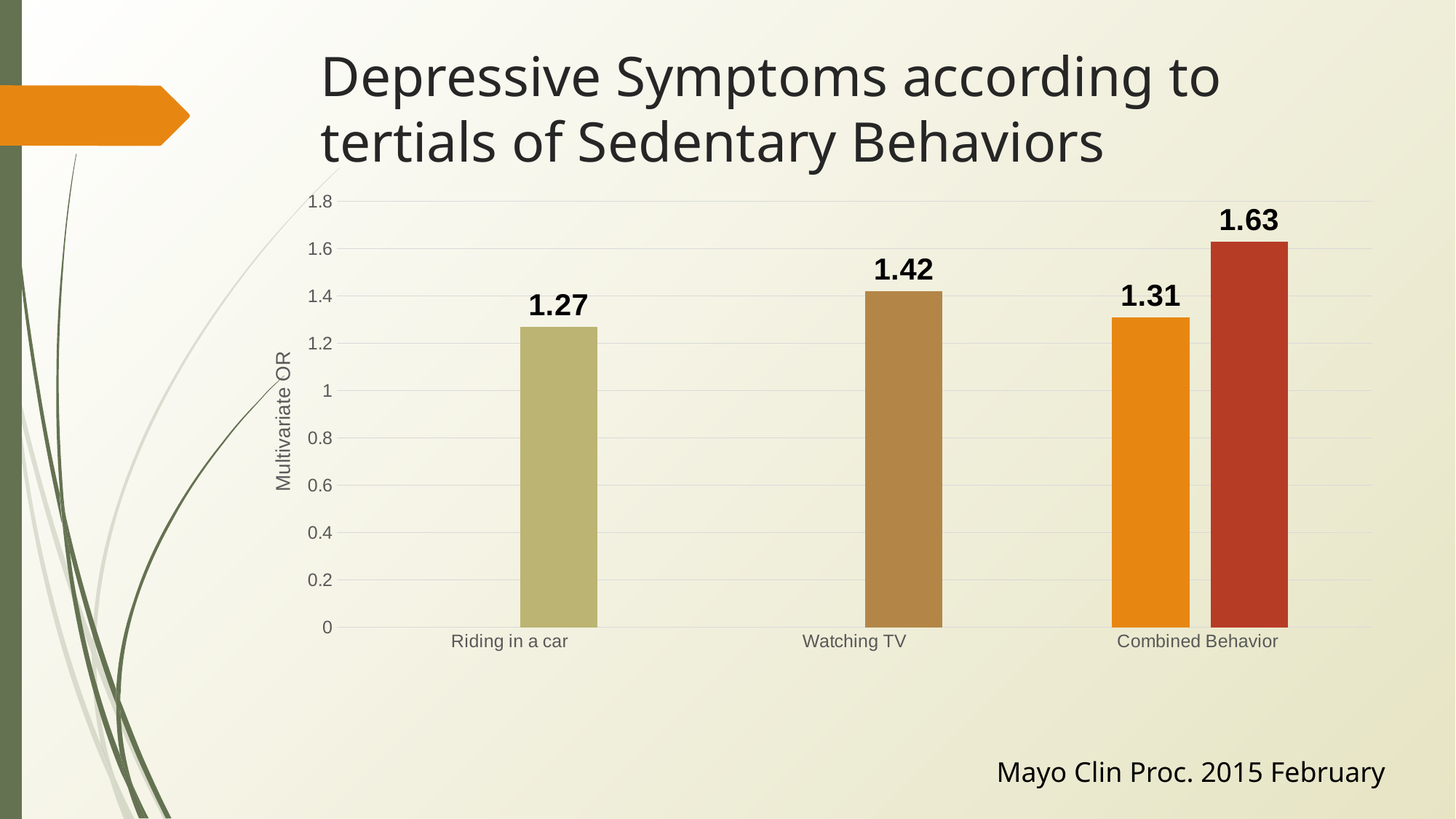
How many categories are shown on the x axis? 3 What kind of chart is shown on the slide? Bar chart What is the label of the y axis? Multivariate OR Which category has the lowest value on the chart? Riding in a car What is the value for Riding in a car? 1.27 What is the value of the shorter bar in the Combined Behavior category? 1.31 What is the difference between the two bars in the Combined Behavior category? 0.32 What is the value of the tallest bar in the Combined Behavior category? 1.63 Which is larger, the value for Watching TV or the value for Riding in a car? Watching TV What is the value for Watching TV? 1.42 Which category contains the highest value on the chart? Combined Behavior What is the difference between the value for Watching TV and the value for Riding in a car? 0.15